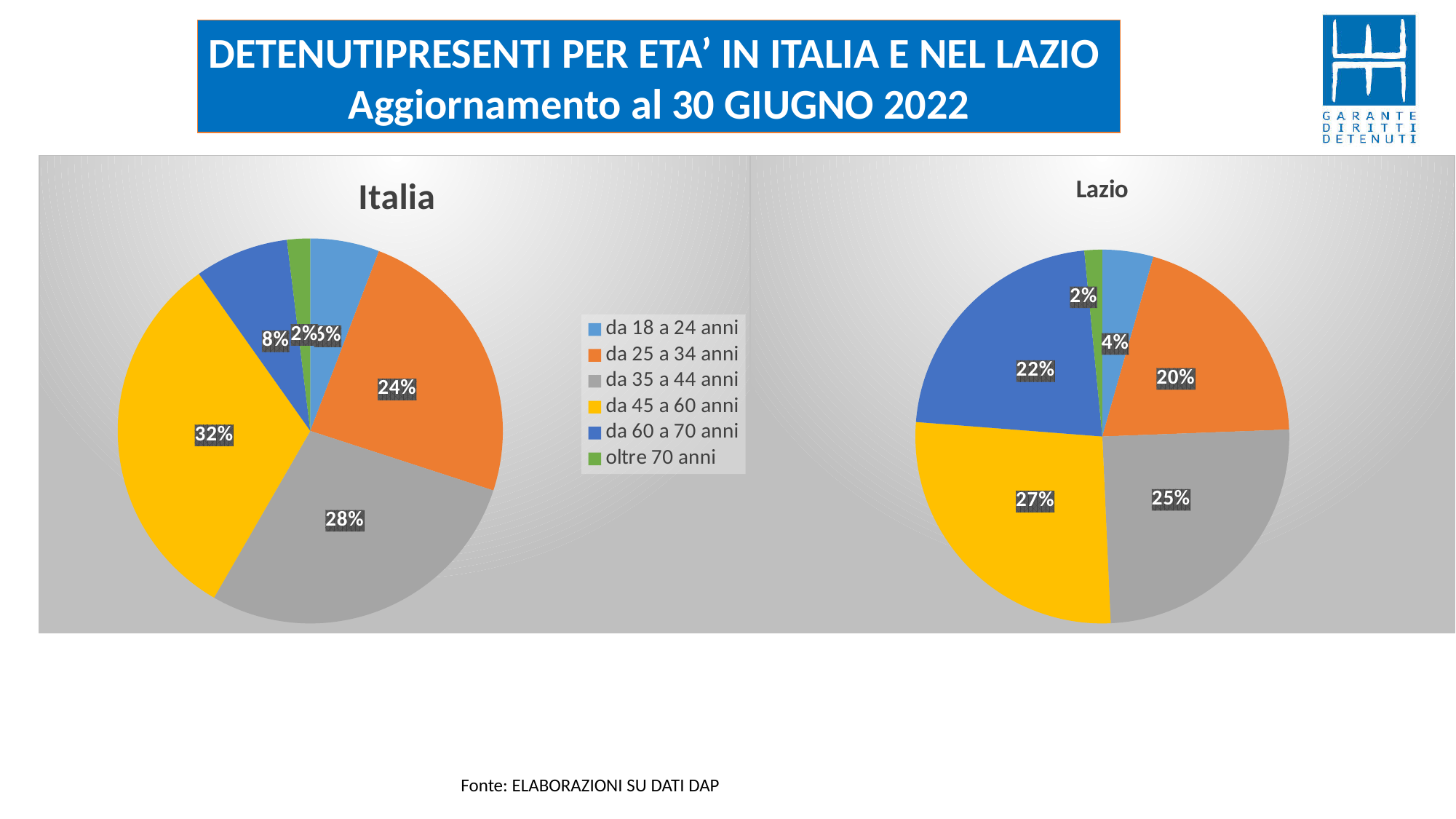
In the Lazio pie chart, which age group has the largest share? da 45 a 60 anni In the Italia pie chart, what share is shown for da 45 a 60 anni? 32% Which is larger: the share for da 60 a 70 anni in the Italia chart or in the Lazio chart? Lazio In the Italia pie chart, what is the difference between the shares for da 45 a 60 anni and da 25 a 34 anni? 8 percentage points How many age groups does the legend list? 6 In the Lazio pie chart, what share is shown for da 60 a 70 anni? 22% In the Italia pie chart, which age group has the smallest share? oltre 70 anni In the Lazio pie chart, what is the difference between the shares for da 35 a 44 anni and da 18 a 24 anni? 21 percentage points In the Lazio pie chart, what share is shown for da 25 a 34 anni? 20% What kind of chart is used for Italia and Lazio on this slide? Pie chart Which colour represents da 45 a 60 anni in the legend? Yellow In the Italia pie chart, what share is shown for da 35 a 44 anni? 28%